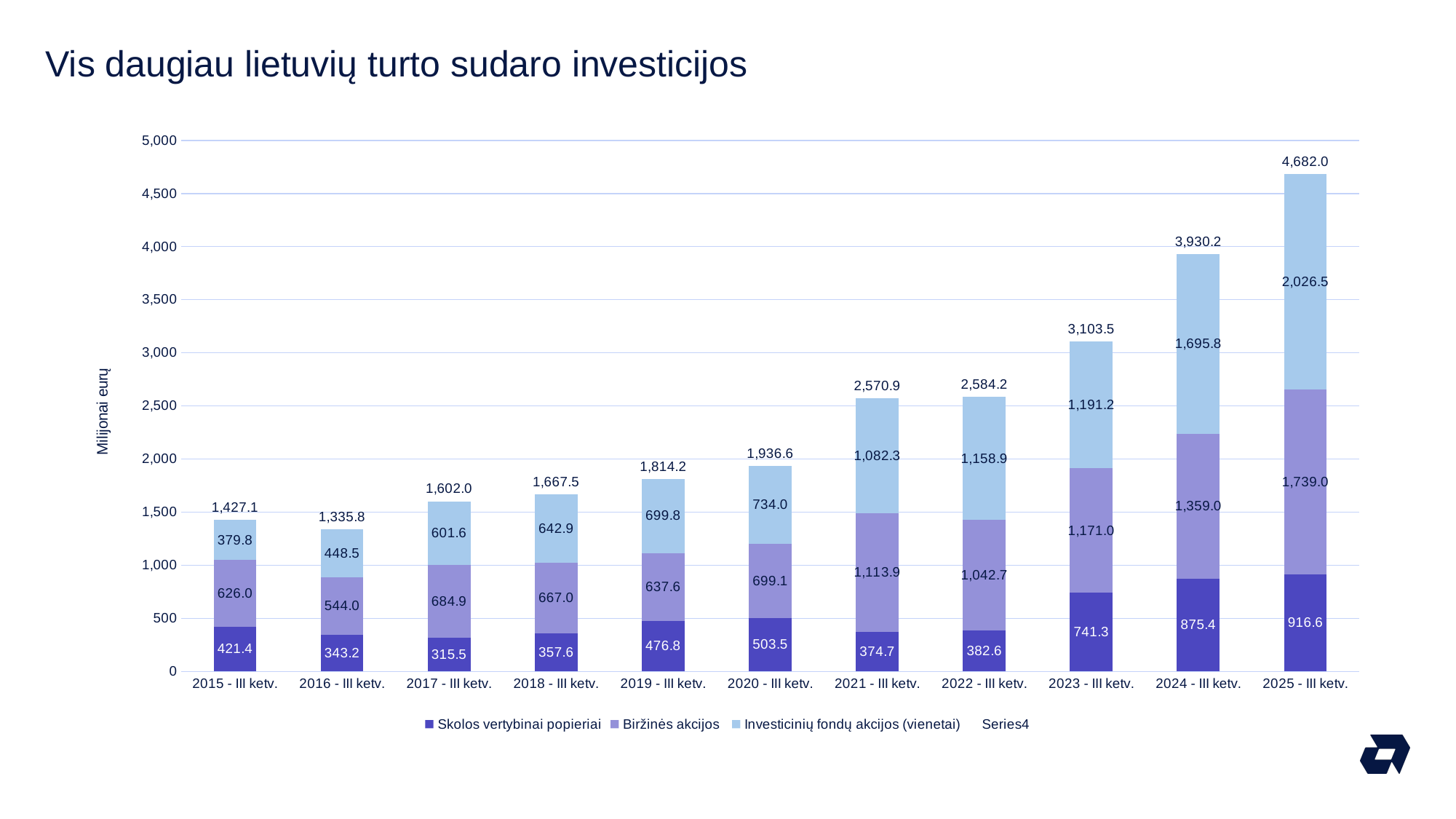
What is the difference between the total for 2025 - III ketv. and the total for 2024 - III ketv.? 751.8 What is the total value shown above the bar for 2025 - III ketv.? 4,682.0 What type of chart is shown on the slide? Stacked bar chart What is the label of the vertical axis? Milijonai eurų How many entries does the legend list? 4 What is the value of Skolos vertybinai popieriai for 2020 - III ketv.? 503.5 Which period has the highest total value? 2025 - III ketv. Which period has the lowest total value? 2016 - III ketv. How many periods are shown on the x axis? 11 Which is larger: Biržinės akcijos in 2022 - III ketv. or Investicinių fondų akcijos (vienetai) in 2022 - III ketv.? Investicinių fondų akcijos (vienetai) What is the value of Biržinės akcijos for 2021 - III ketv.? 1,113.9 What is the value of Investicinių fondų akcijos (vienetai) for 2024 - III ketv.? 1,695.8